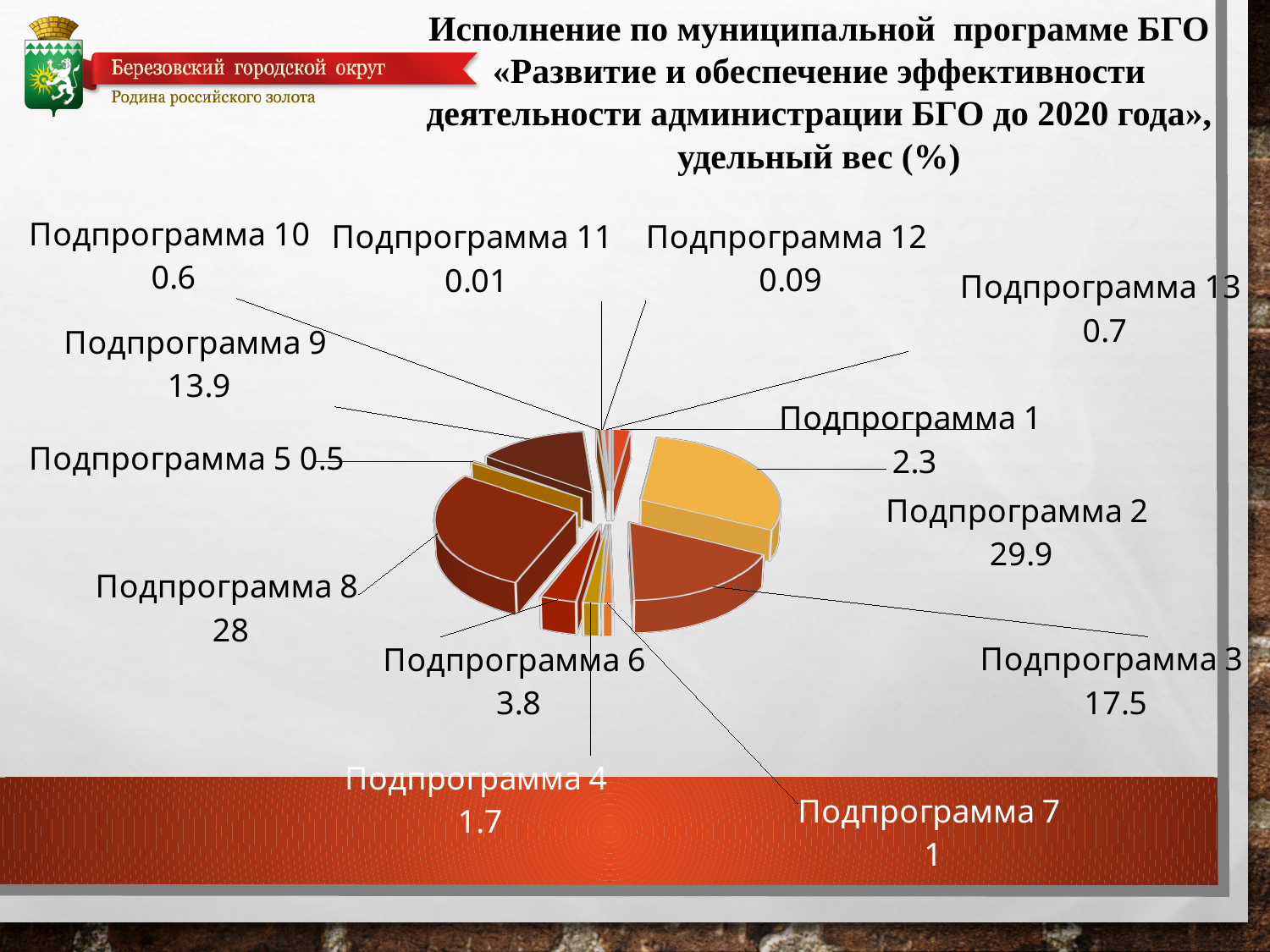
What is the value shown for Подпрограмма 6? 3.8 What is the value shown for Подпрограмма 11? 0.01 Which is larger, the value for Подпрограмма 8 or the value for Подпрограмма 3? Подпрограмма 8 What is the difference between the values for Подпрограмма 2 and Подпрограмма 8? 1.9 What unit does the chart title say the values are expressed in? удельный вес (%) Which subprogram has the largest share in the pie chart? Подпрограмма 2 What is the value shown for Подпрограмма 9? 13.9 What is the value shown for Подпрограмма 2? 29.9 Which subprogram has the smallest share in the pie chart? Подпрограмма 11 What is the difference between the values for Подпрограмма 3 and Подпрограмма 9? 3.6 What type of chart is shown on the slide? pie chart How many subprograms (slices) are shown in the pie chart? 13